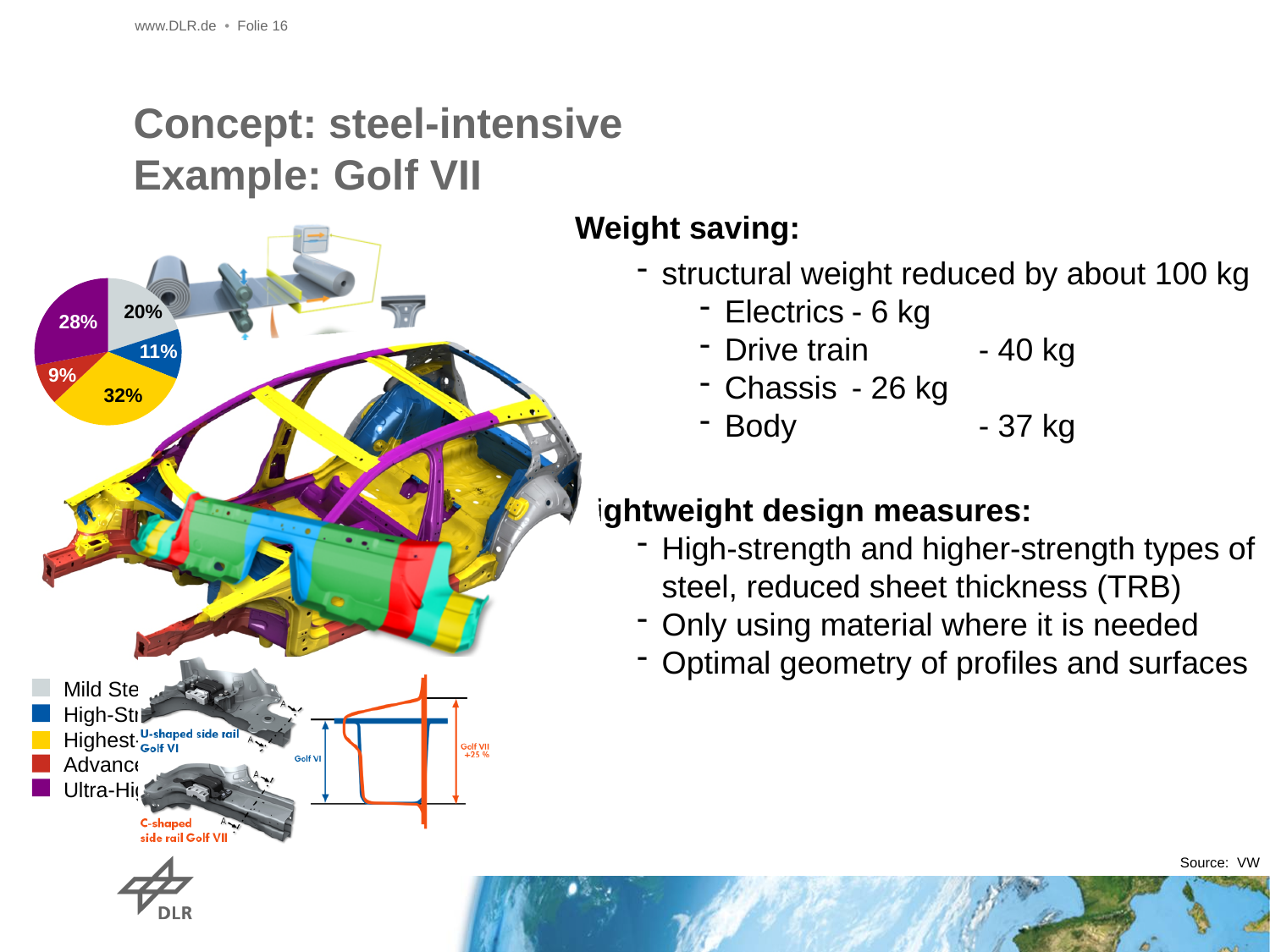
What kind of chart is shown on the left of the slide? pie chart What is the smallest slice of the pie chart? 9% In the pie chart, which slice is larger, the grey slice or the blue slice? the grey slice In the pie chart, how many percentage points larger is the grey slice than the red slice? 11 What percentage is shown for the purple slice of the pie chart? 28% What percentage is shown for the grey slice of the pie chart? 20% How many slices does the pie chart have? 5 How many entries does the legend below the pie chart list? 5 What is the largest slice of the pie chart? 32% In the pie chart, how many percentage points larger is the yellow slice than the purple slice? 4 What percentage is shown for the red slice of the pie chart? 9% What percentage is shown for the blue slice of the pie chart? 11%